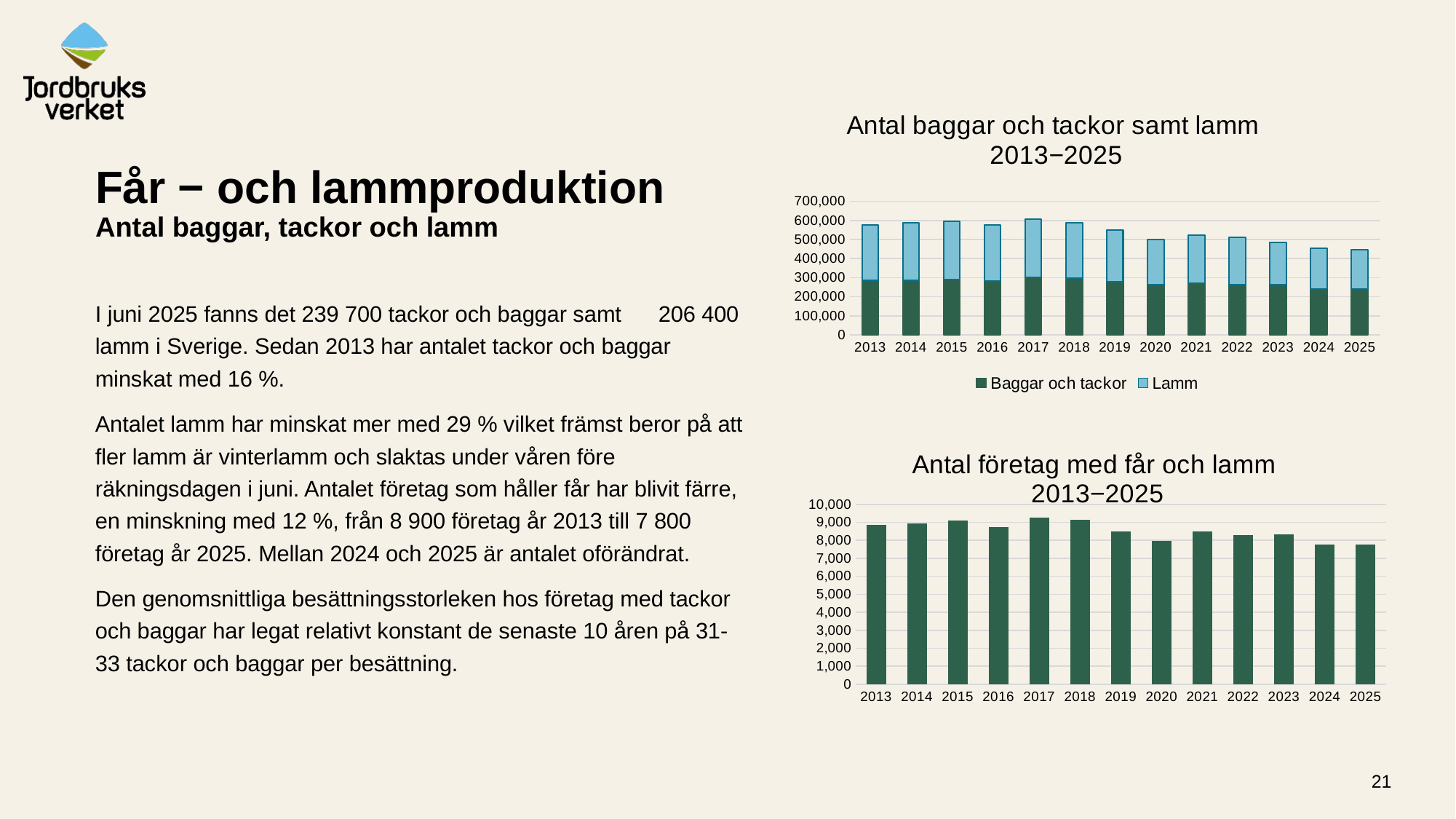
In the top chart 'Antal baggar och tackor samt lamm 2013−2025', which series is shown in light blue? Lamm How many series does the legend of the top chart 'Antal baggar och tackor samt lamm 2013−2025' list? 2 In the top chart 'Antal baggar och tackor samt lamm 2013−2025', is the total bar for 2025 greater or less than 500,000? less What kind of chart is the bottom chart, 'Antal företag med får och lamm 2013−2025'? Bar chart In the bottom chart 'Antal företag med får och lamm 2013−2025', which year has the highest bar? 2017 In the top chart 'Antal baggar och tackor samt lamm 2013−2025', which year has the highest total bar? 2017 In the top chart 'Antal baggar och tackor samt lamm 2013−2025', how many years are shown on the x axis? 13 In the bottom chart 'Antal företag med får och lamm 2013−2025', do the values generally rise or fall from 2013 to 2025? Fall What kind of chart is the top chart, 'Antal baggar och tackor samt lamm 2013−2025'? Stacked bar chart In the top chart 'Antal baggar och tackor samt lamm 2013−2025', is the total bar for 2013 greater or less than 500,000? greater In the bottom chart 'Antal företag med får och lamm 2013−2025', is the value for 2025 greater or less than 8,000? less